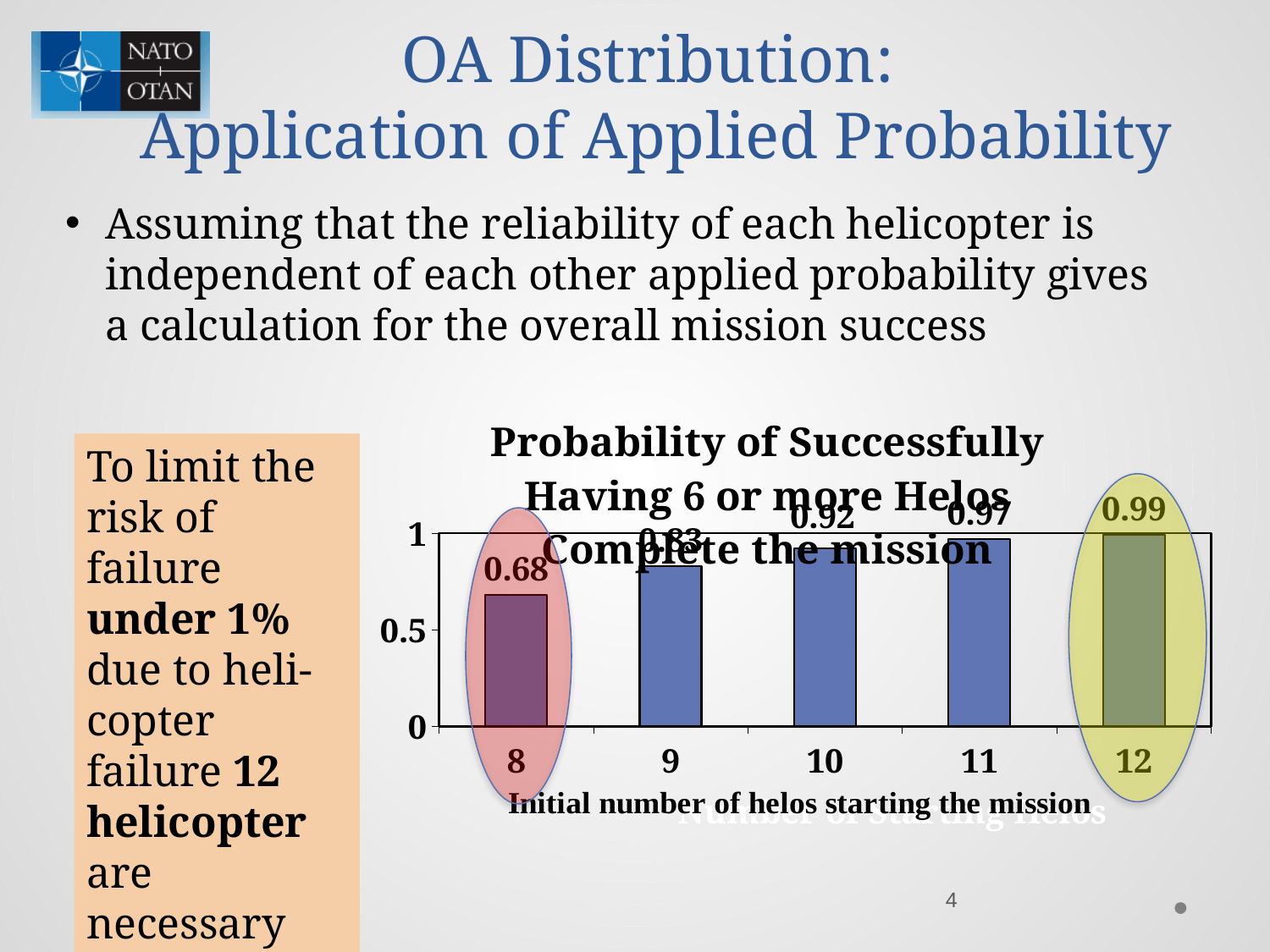
What is the difference between the probability for 12 helos and the probability for 8 helos? 0.31 Do the probability values rise or fall as the initial number of helos increases? rise What is the probability value shown for 12 initial helos? 0.99 Which has a higher probability value, 10 helos or 11 helos? 11 Which initial number of helos has the highest probability of success? 12 Is the value for 8 helos greater or less than 0.5? greater What kind of chart is shown on the slide? bar chart Which initial number of helos has the lowest probability of success? 8 What is the probability value shown for 8 initial helos? 0.68 What is the probability value shown for 11 initial helos? 0.97 What is the probability value shown for 10 initial helos? 0.92 How many categories are shown on the x axis of the chart? 5